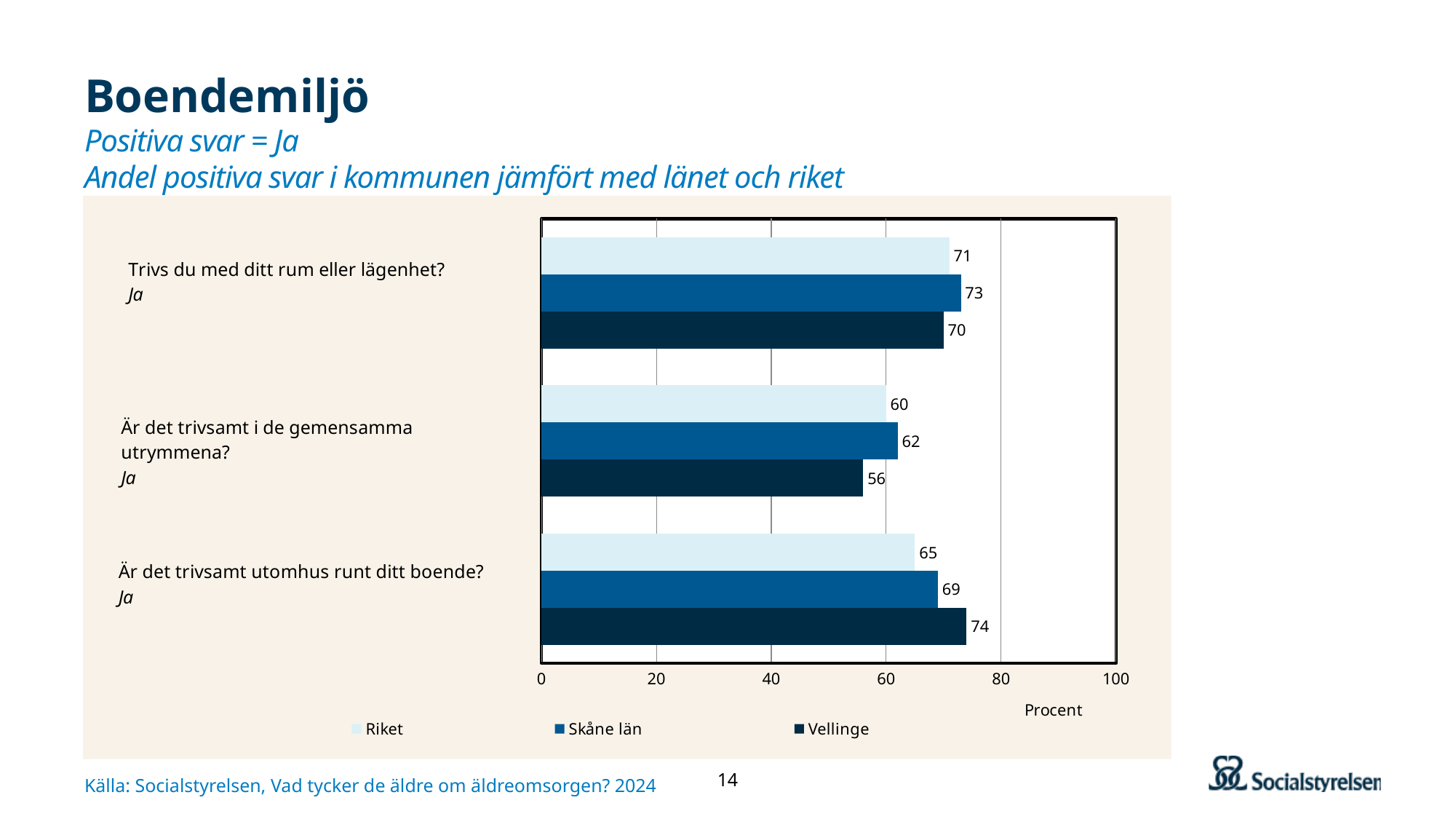
Which series has the lowest value for "Är det trivsamt utomhus runt ditt boende?"? Riket What is the difference between the Skåne län and Vellinge values for "Är det trivsamt i de gemensamma utrymmena?"? 6 How many questions (categories) are shown on the chart? 3 Which series has the highest value for "Är det trivsamt i de gemensamma utrymmena?"? Skåne län What is the value for Riket on "Trivs du med ditt rum eller lägenhet?"? 71 What is the value for Skåne län on "Är det trivsamt i de gemensamma utrymmena?"? 62 What is the label of the x axis? Procent Which is larger for "Är det trivsamt utomhus runt ditt boende?": Vellinge or Skåne län? Vellinge What kind of chart is shown on the slide? bar chart What is the value for Vellinge on "Är det trivsamt utomhus runt ditt boende?"? 74 Is the Vellinge value for "Är det trivsamt i de gemensamma utrymmena?" greater or less than 60? less How many series does the legend list? 3